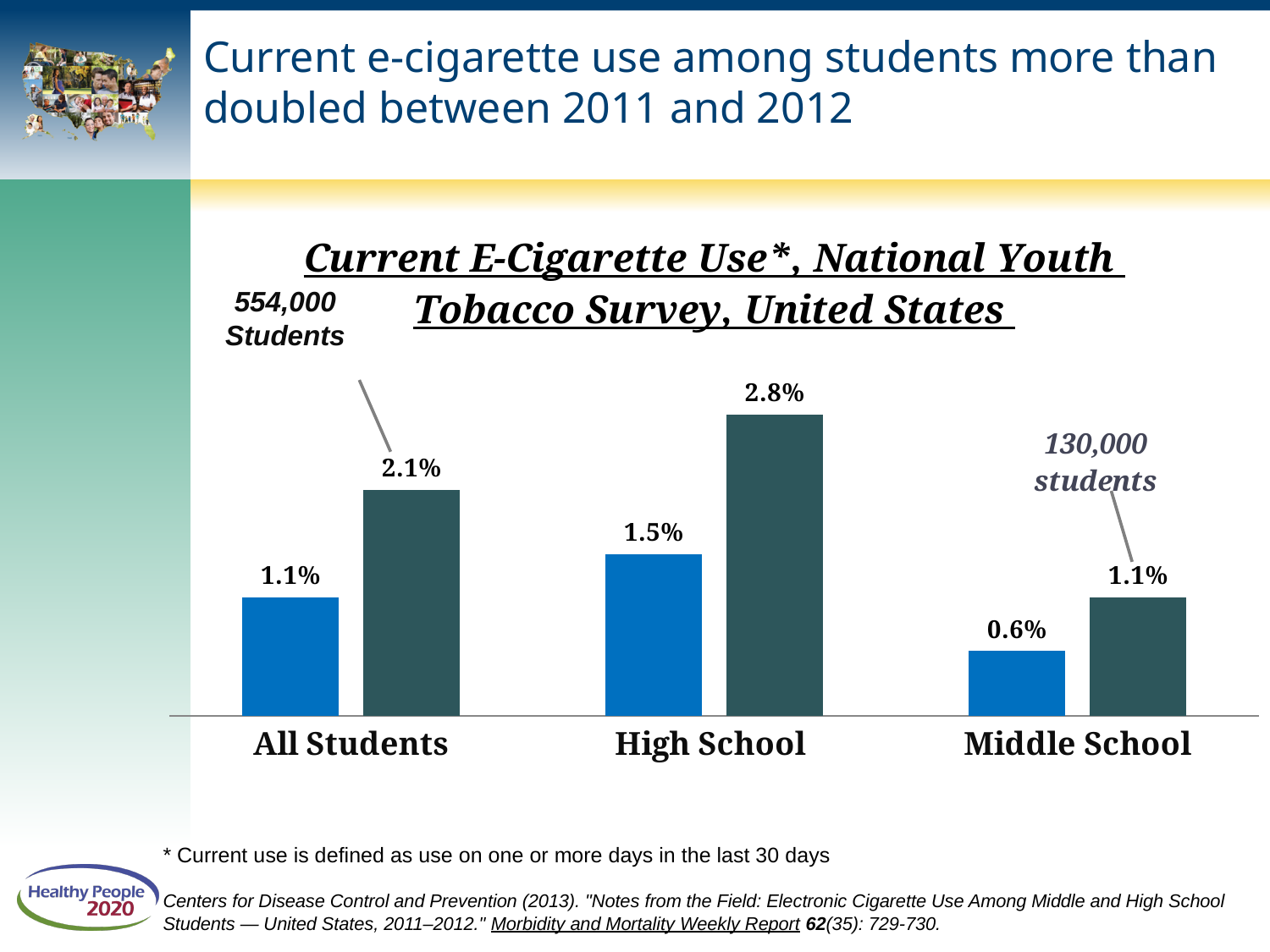
What is the difference between the dark (right) bar and the blue (left) bar for All Students? 1.0% What is the title of the chart? Current E-Cigarette Use*, National Youth Tobacco Survey, United States What is the value of the dark (right) bar for High School? 2.8% What is the difference between the dark (right) bar and the blue (left) bar for High School? 1.3% Which is larger: the blue (left) bar for High School or the dark (right) bar for Middle School? the blue (left) bar for High School What is the value of the blue (left) bar for All Students? 1.1% Which category has the highest value among the dark (right) bars? High School What type of chart is shown on the slide? bar chart What is the value of the blue (left) bar for Middle School? 0.6% What is the value of the dark (right) bar for Middle School? 1.1% How many categories are shown on the x axis? 3 Which category has the lowest value among the blue (left) bars? Middle School